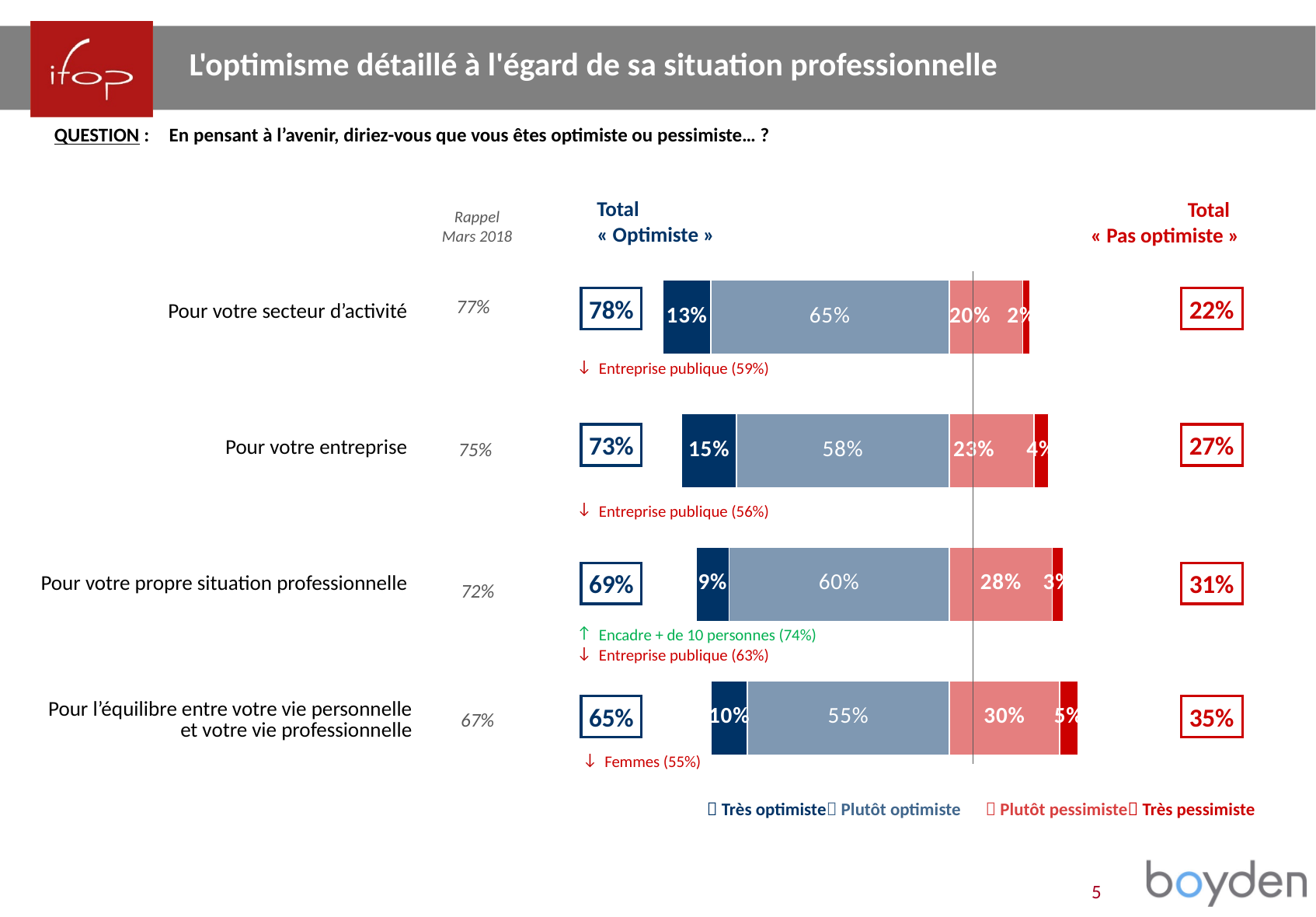
What is the Total « Optimiste » value for "Pour votre propre situation professionnelle"? 69% How many series does the legend list? 4 Which category has the lowest "Très optimiste" value? Pour votre propre situation professionnelle Which category has the highest Total « Optimiste » value? Pour votre secteur d'activité What was the Rappel Mars 2018 value for "Pour votre entreprise"? 75% What is the difference between the Total « Pas optimiste » values for "Pour l'équilibre entre votre vie personnelle et votre vie professionnelle" and "Pour votre secteur d'activité"? 13 points What kind of chart is shown on the slide? Stacked bar chart What is the "Très optimiste" value for "Pour votre secteur d'activité"? 13% Which is larger: the "Très pessimiste" value for "Pour votre entreprise" or for "Pour votre secteur d'activité"? Pour votre entreprise What is the "Plutôt optimiste" value for "Pour votre entreprise"? 58% How many categories (rows) does the chart show? 4 What is the "Plutôt pessimiste" value for "Pour l'équilibre entre votre vie personnelle et votre vie professionnelle"? 30%